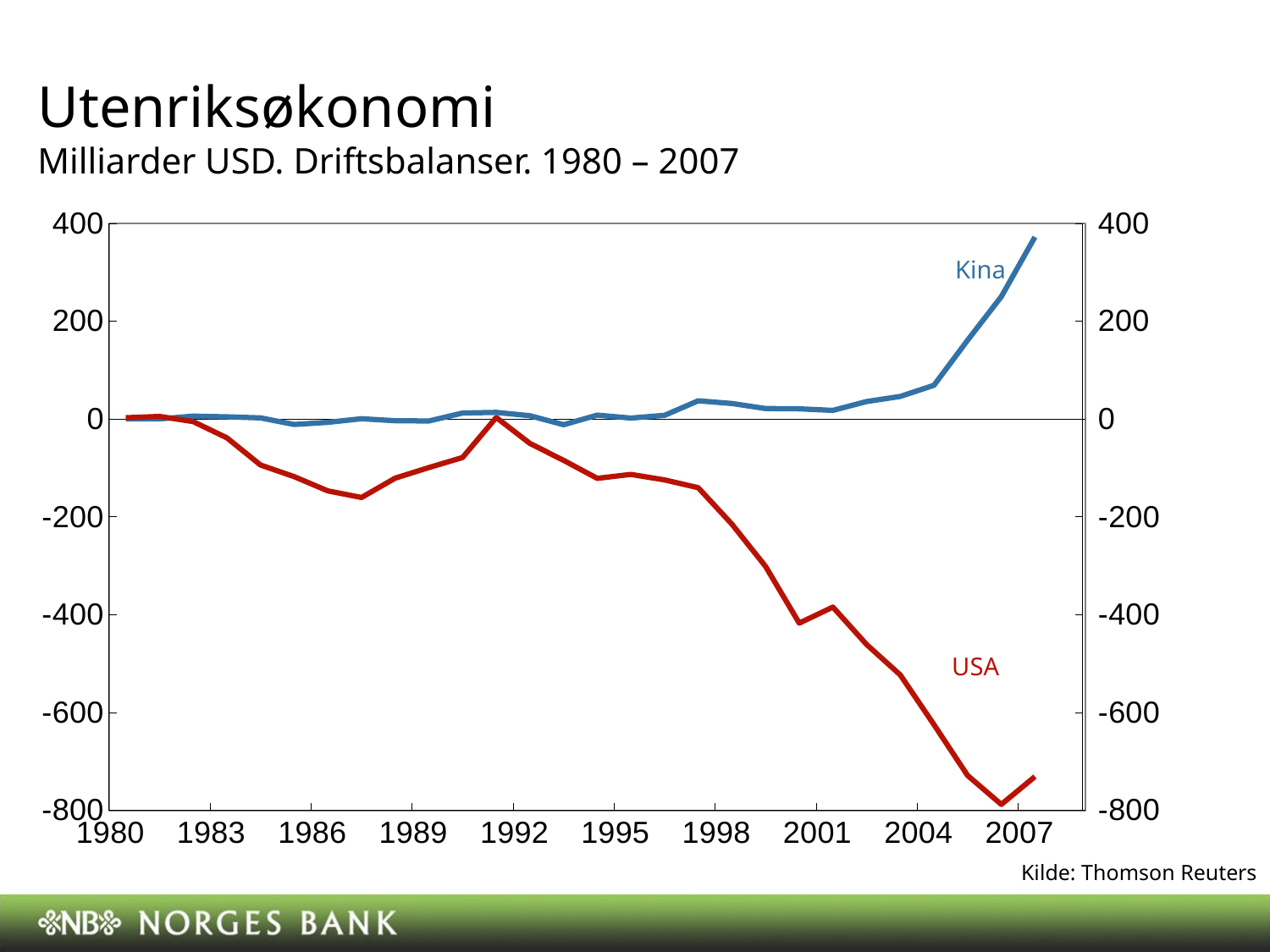
Is the value for Kina in 2004 greater or less than 200? less Is the value for USA in 2007 greater or less than -600? less Is the value for Kina in 2007 greater or less than 200? greater How many series are plotted on the chart? 2 Does the Kina series rise or fall between 2004 and 2007? rise Does the USA series rise or fall between 2001 and 2006? fall What kind of chart is shown on the slide? line chart Which two series are labelled on the chart? Kina and USA What is the source cited for the chart? Thomson Reuters Which series has the higher value in 2007, Kina or USA? Kina